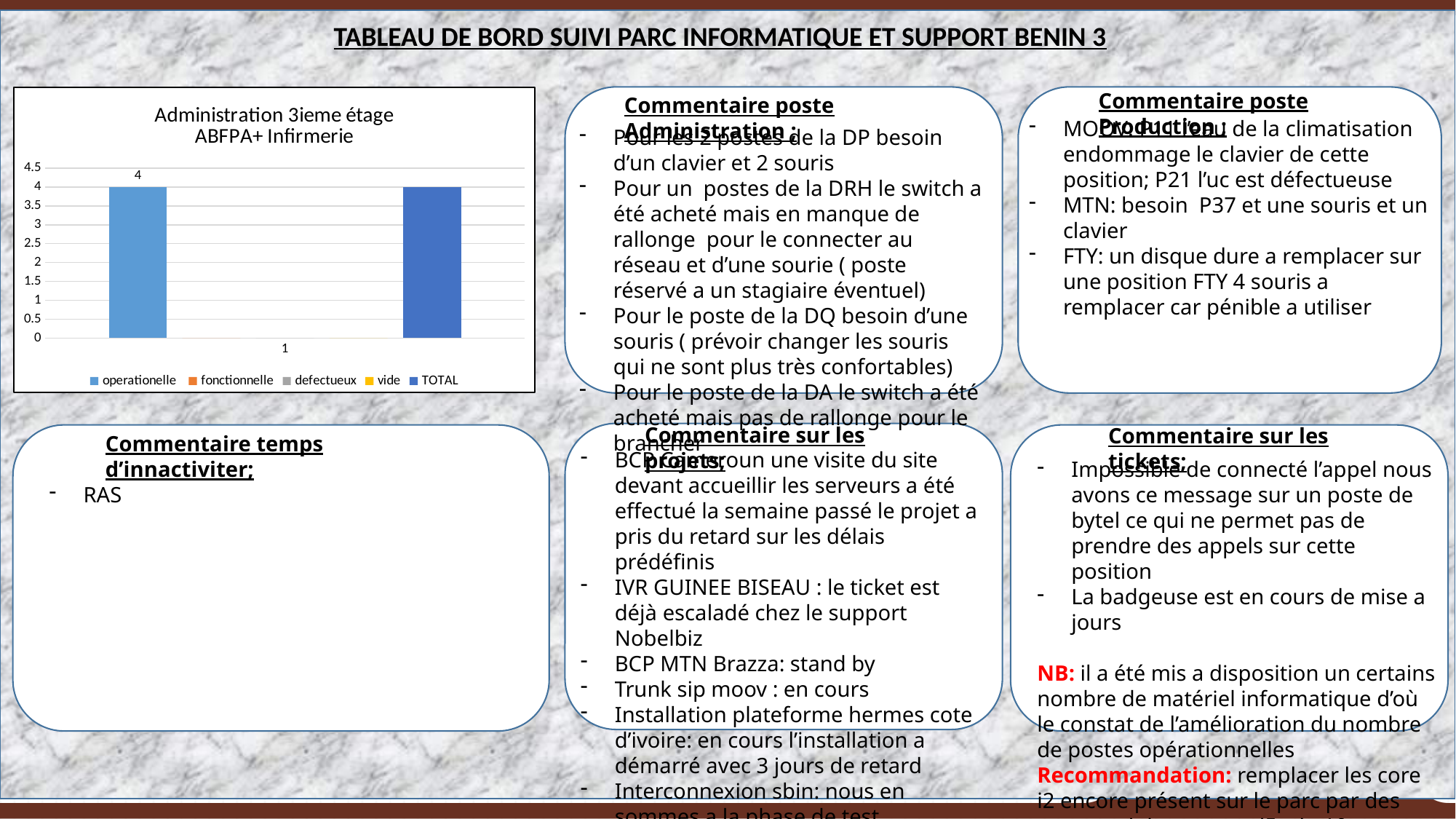
What is the highest tick value shown on the y axis of the chart? 4.5 Is the value for operationelle greater or less than 2? greater What is the title of the chart? Administration 3ieme étage ABFPA+ Infirmerie What is the value of the operationelle bar? 4 Is the value for TOTAL greater or less than 3? greater How many categories are shown on the x axis of the chart? 1 What is the difference between the operationelle value and the TOTAL value? 0 How many series does the chart legend list? 5 Which is larger, the operationelle value or the fonctionnelle value? operationelle What kind of chart is shown on the slide? bar chart What is the value of the TOTAL bar? 4